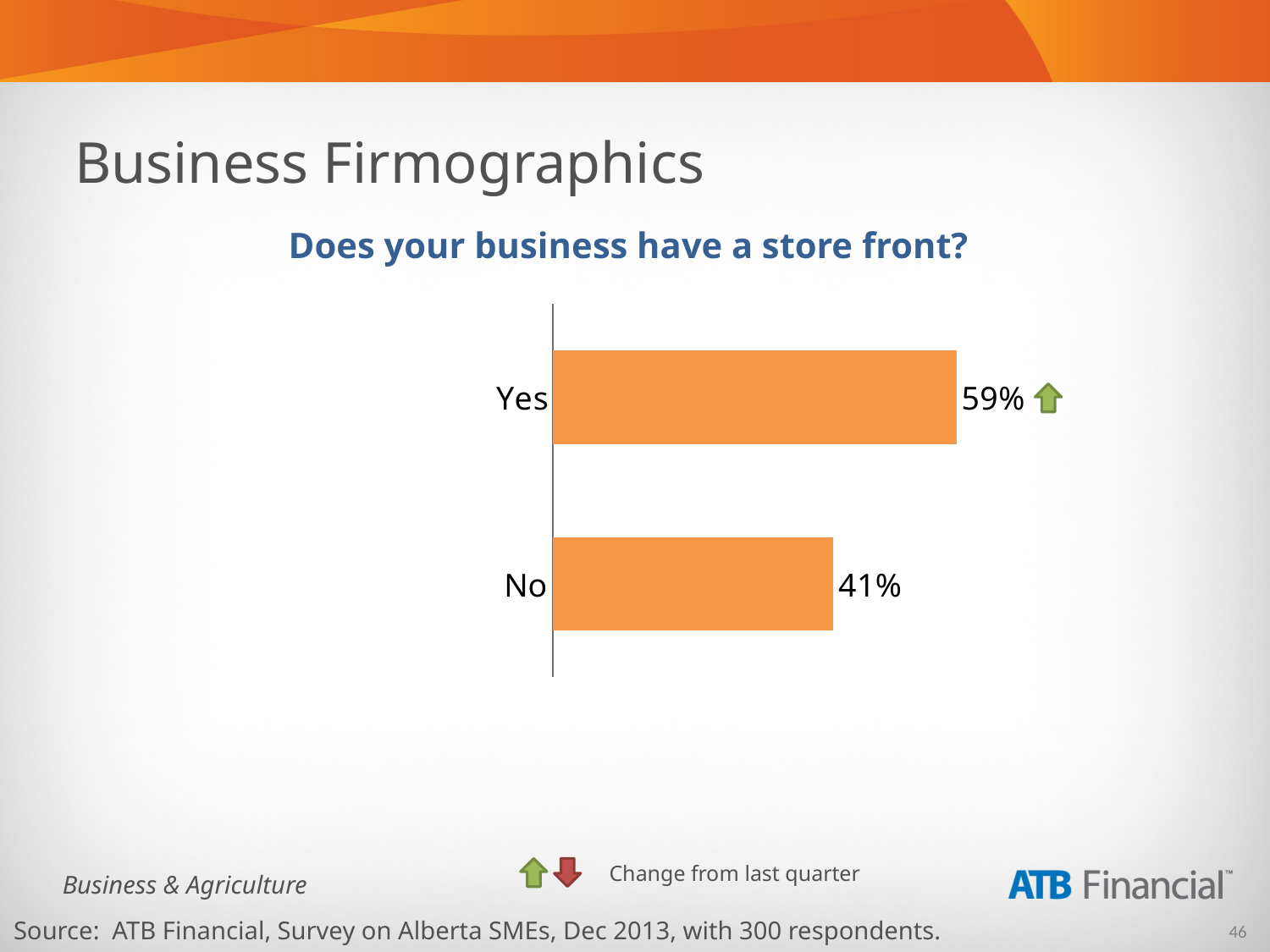
Which response shows an increase from last quarter, as indicated by the green arrow? Yes What percentage of respondents answered No to having a store front? 41% Which response has the lower percentage? No What question does the chart title ask? Does your business have a store front? Which response has the higher percentage, Yes or No? Yes How many response categories are shown in the chart? 2 What type of chart is used on this slide? bar chart What percentage of respondents answered Yes to having a store front? 59% Is the value for Yes larger or smaller than the value for No? larger What is the difference in percentage points between the Yes and No responses? 18 What is the total of the Yes and No percentages? 100%